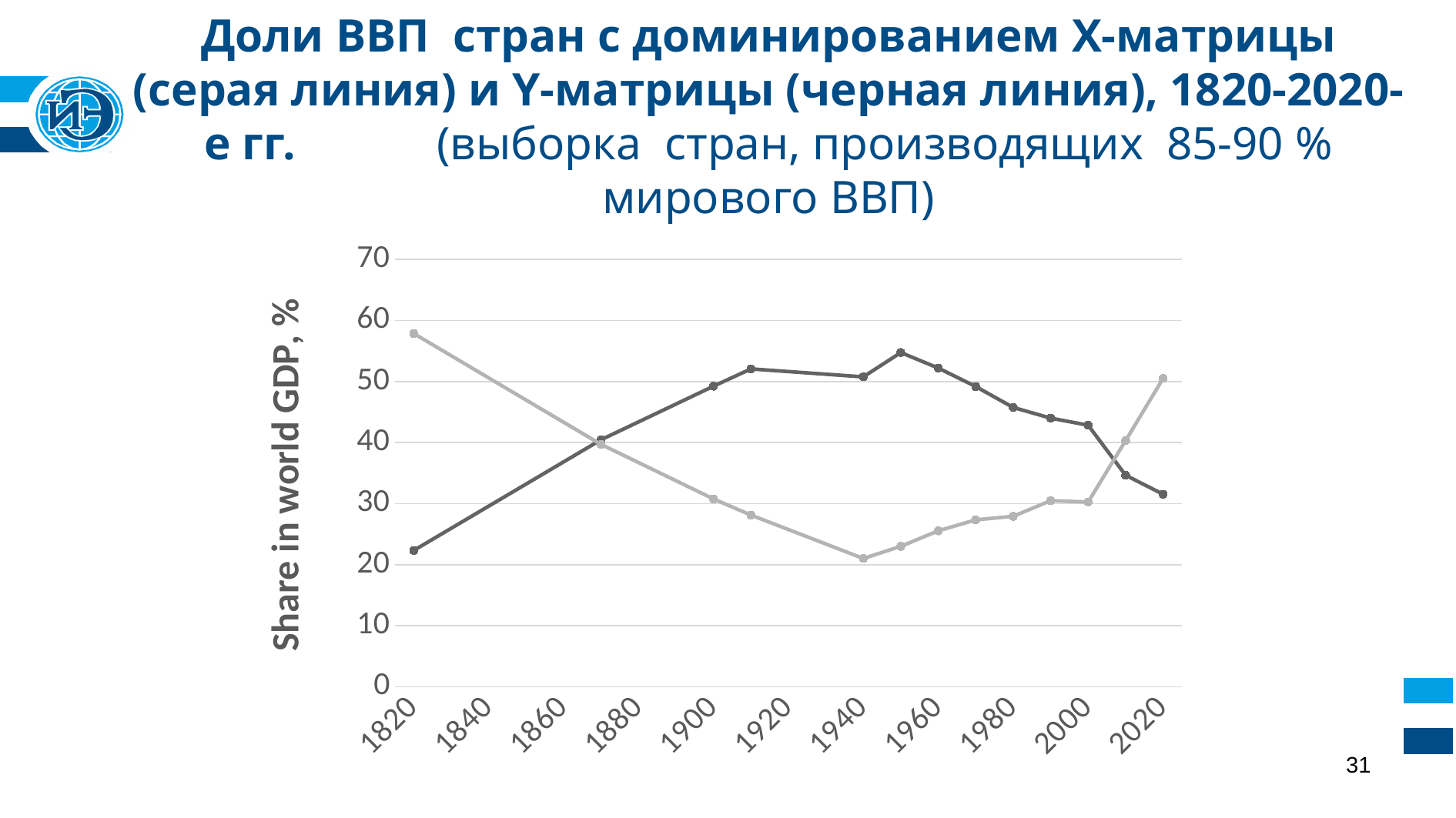
How many lines are plotted on the chart? 2 Does the black line (Y-matrix countries) rise or fall between 1950 and 2020? fall Is the value of the grey line (X-matrix countries) in 1820 greater or less than 50? greater Does the grey line (X-matrix countries) rise or fall between 1820 and 1940? fall What kind of chart is shown on the slide? line chart Around 1950, which line has the higher value, the grey line or the black line? the black line Is the value of the black line (Y-matrix countries) in 2020 greater or less than 40? less Is the value of the black line (Y-matrix countries) around 1950 greater or less than 50? greater What is the label of the vertical axis of the chart? Share in world GDP, % In 1820, which line has the higher value, the grey line or the black line? the grey line